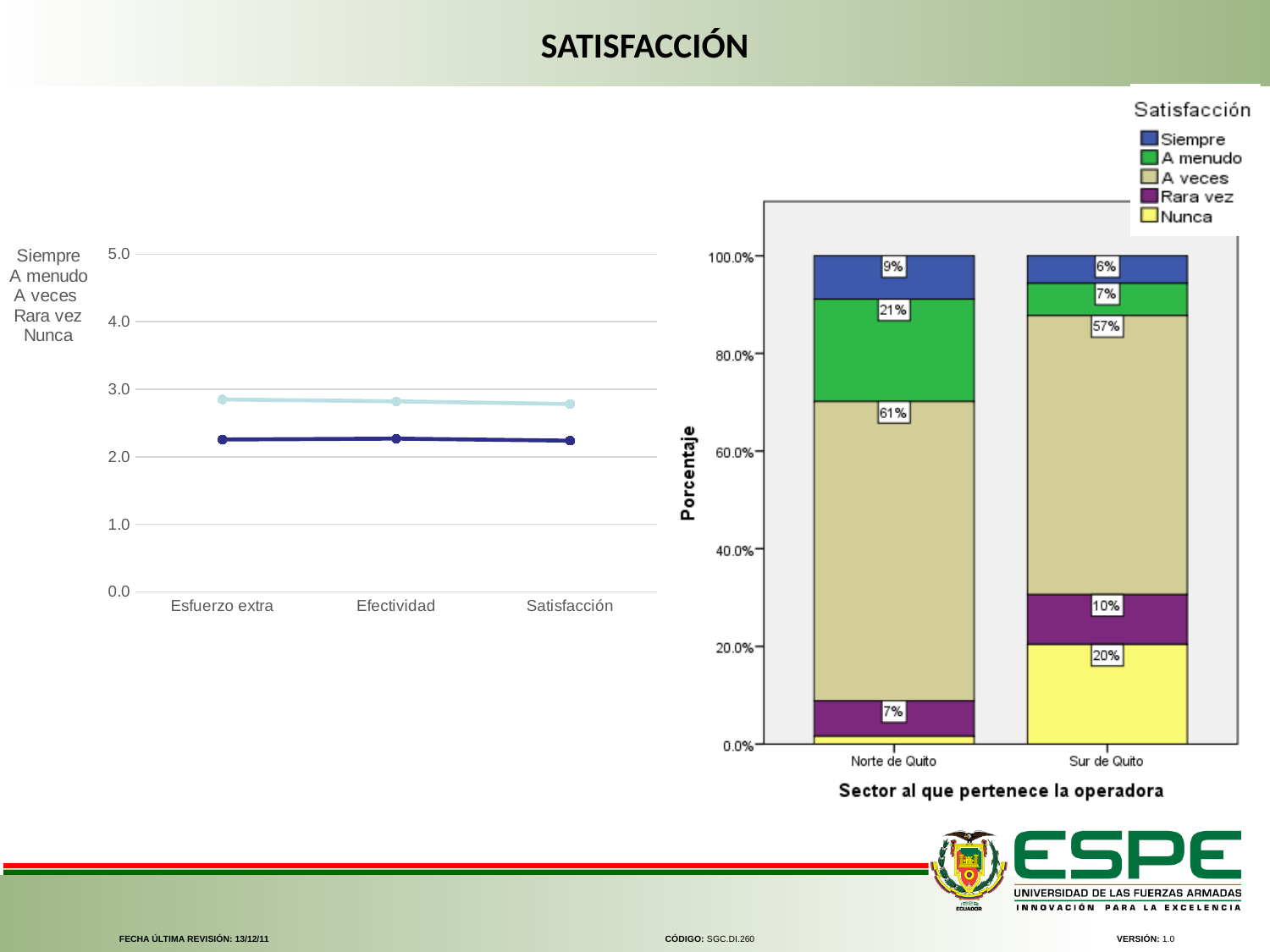
How many series does the legend of the stacked bar chart on the right list? 5 What kind of chart is the chart on the right of the slide? Stacked bar chart How many categories are shown on the x axis of the line chart on the left? 3 What kind of chart is the chart on the left of the slide? Line chart In the stacked bar chart on the right, which sector has the larger 'Siempre' percentage, Norte de Quito or Sur de Quito? Norte de Quito In the stacked bar chart on the right, what percentage is shown for 'A veces' in Norte de Quito? 61% In the stacked bar chart on the right, which response category has the largest share for Sur de Quito? A veces In the stacked bar chart on the right, what is the difference in percentage points between the 'A menudo' values for Norte de Quito and Sur de Quito? 14 In the stacked bar chart on the right, what percentage is shown for 'Rara vez' in Sur de Quito? 10% How many sectors (categories) are shown on the x axis of the stacked bar chart on the right? 2 In the line chart on the left, is the value of the dark blue line at 'Esfuerzo extra' greater or less than 3.0? less In the stacked bar chart on the right, what percentage is shown for 'Nunca' in Sur de Quito? 20%